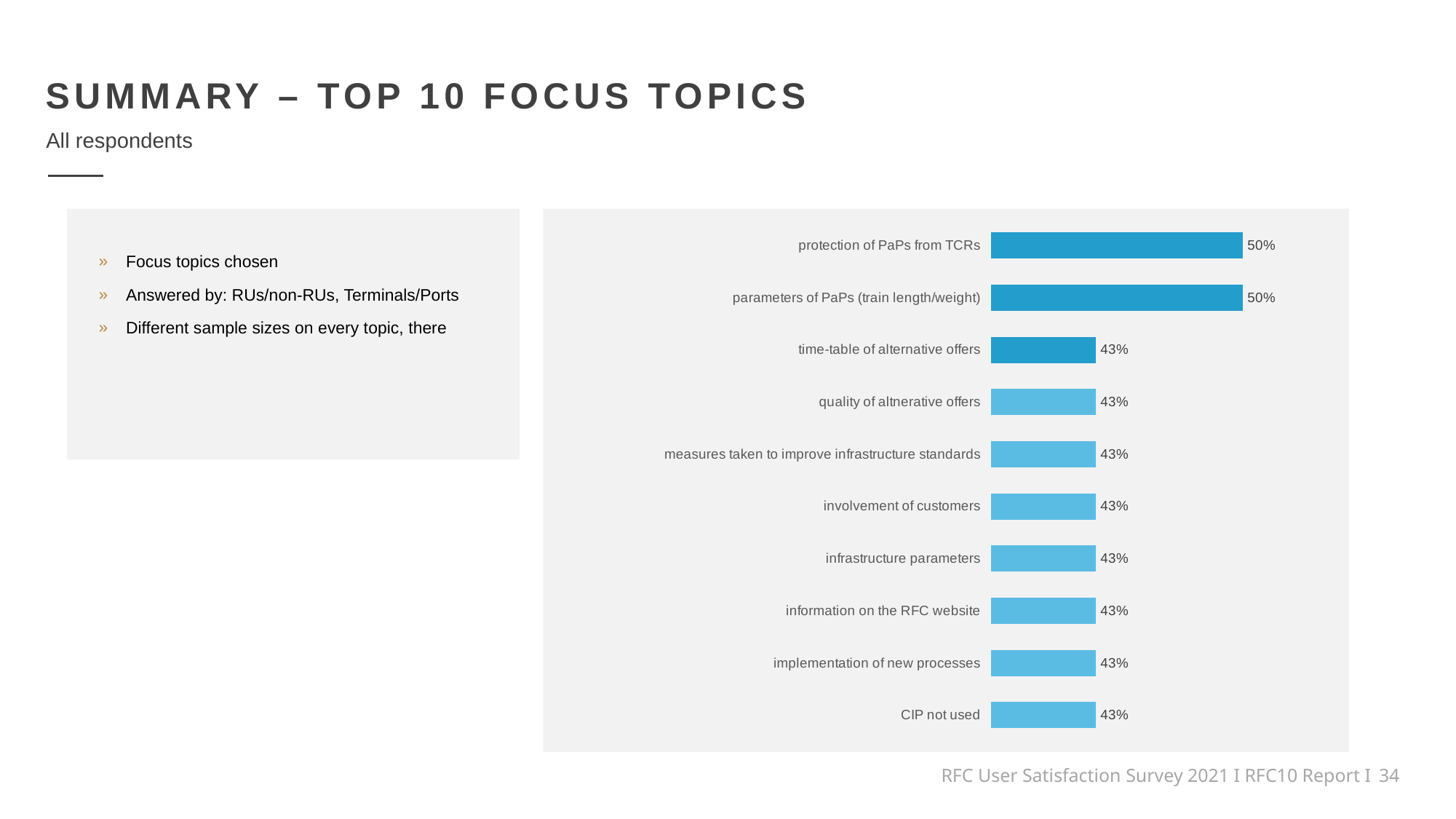
Which category is listed at the bottom of the chart? CIP not used What is the value for "protection of PaPs from TCRs"? 50% What kind of chart is shown on the slide? bar chart How many categories have a value of 43%? 8 How many categories have a value of 50%? 2 What is the value for "parameters of PaPs (train length/weight)"? 50% Which category is listed at the top of the chart? protection of PaPs from TCRs What is the difference between the value for "protection of PaPs from TCRs" and the value for "time-table of alternative offers"? 7% How many categories are shown in the chart? 10 What is the value for "CIP not used"? 43% Which is larger, the value for "parameters of PaPs (train length/weight)" or the value for "involvement of customers"? parameters of PaPs (train length/weight) What is the value for "information on the RFC website"? 43%